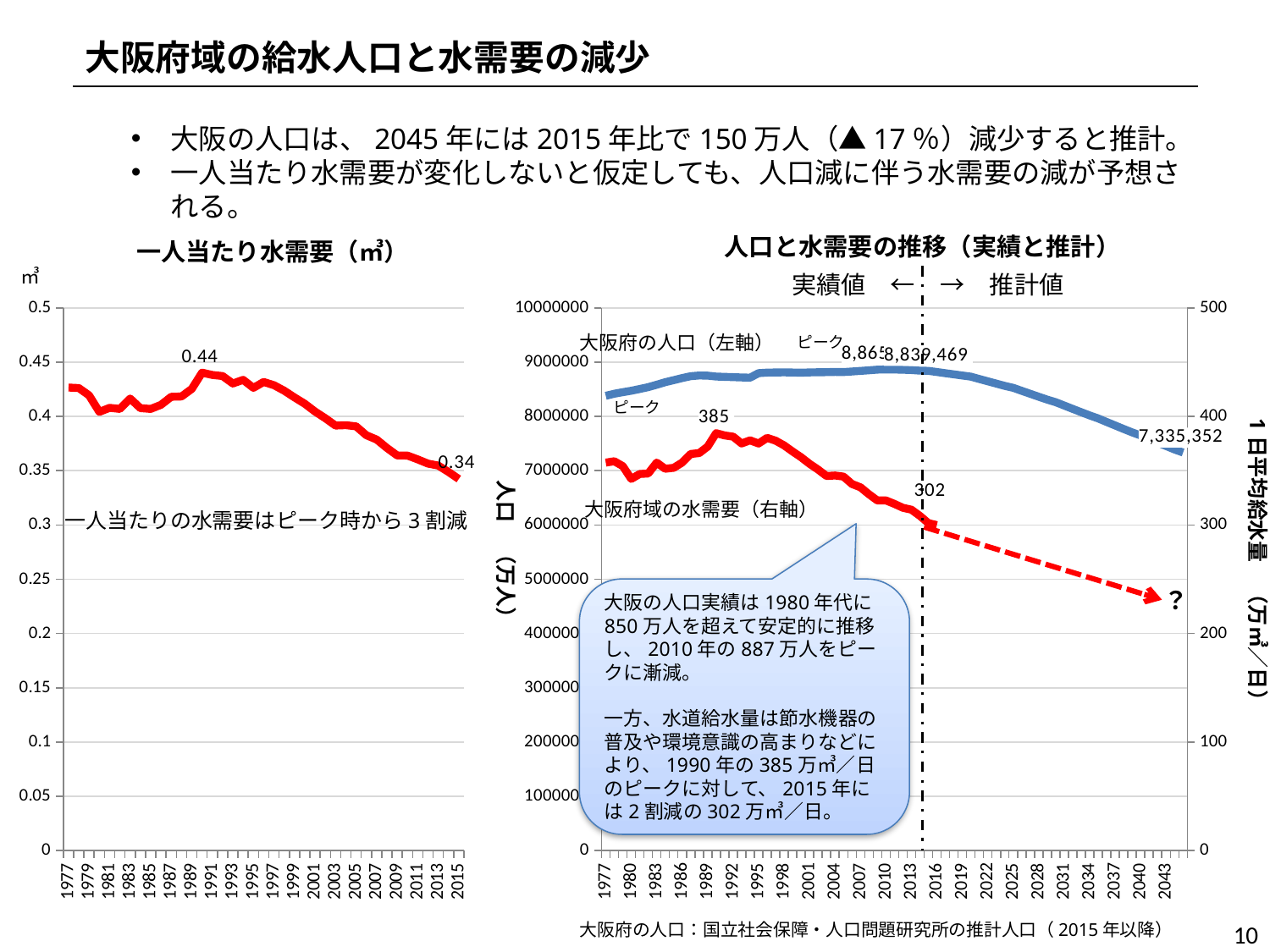
In the right chart 人口と水需要の推移（実績と推計）, what is the difference between the labelled peak water demand 385 and the labelled value 302? 83 In the left chart 一人当たり水需要（㎥）, what value is labelled at the end of the line in 2015? 0.34 In the right chart 人口と水需要の推移（実績と推計）, what value of 大阪府域の水需要 is labelled at the end of the actual (実績) period? 302 How many data series are plotted in the right chart 人口と水需要の推移（実績と推計）? 2 In the right chart 人口と水需要の推移（実績と推計）, what is the labelled peak value of 大阪府域の水需要? 385 In the right chart 人口と水需要の推移（実績と推計）, is the population value for 1977 greater or less than 8000000? greater What kind of chart is the left chart titled 一人当たり水需要（㎥）? line chart In the left chart 一人当たり水需要（㎥）, is the value for 1981 greater or less than 0.45? less In the left chart 一人当たり水需要（㎥）, do the values rise or fall along the x axis after the 0.44 peak? fall In the left chart 一人当たり水需要（㎥）, what is the peak value labelled on the line? 0.44 In the left chart 一人当たり水需要（㎥）, what is the difference between the labelled peak value and the labelled 2015 value? 0.10 In the right chart 人口と水需要の推移（実績と推計）, what is the labelled projected population value at the end of the 大阪府の人口 line? 7,335,352